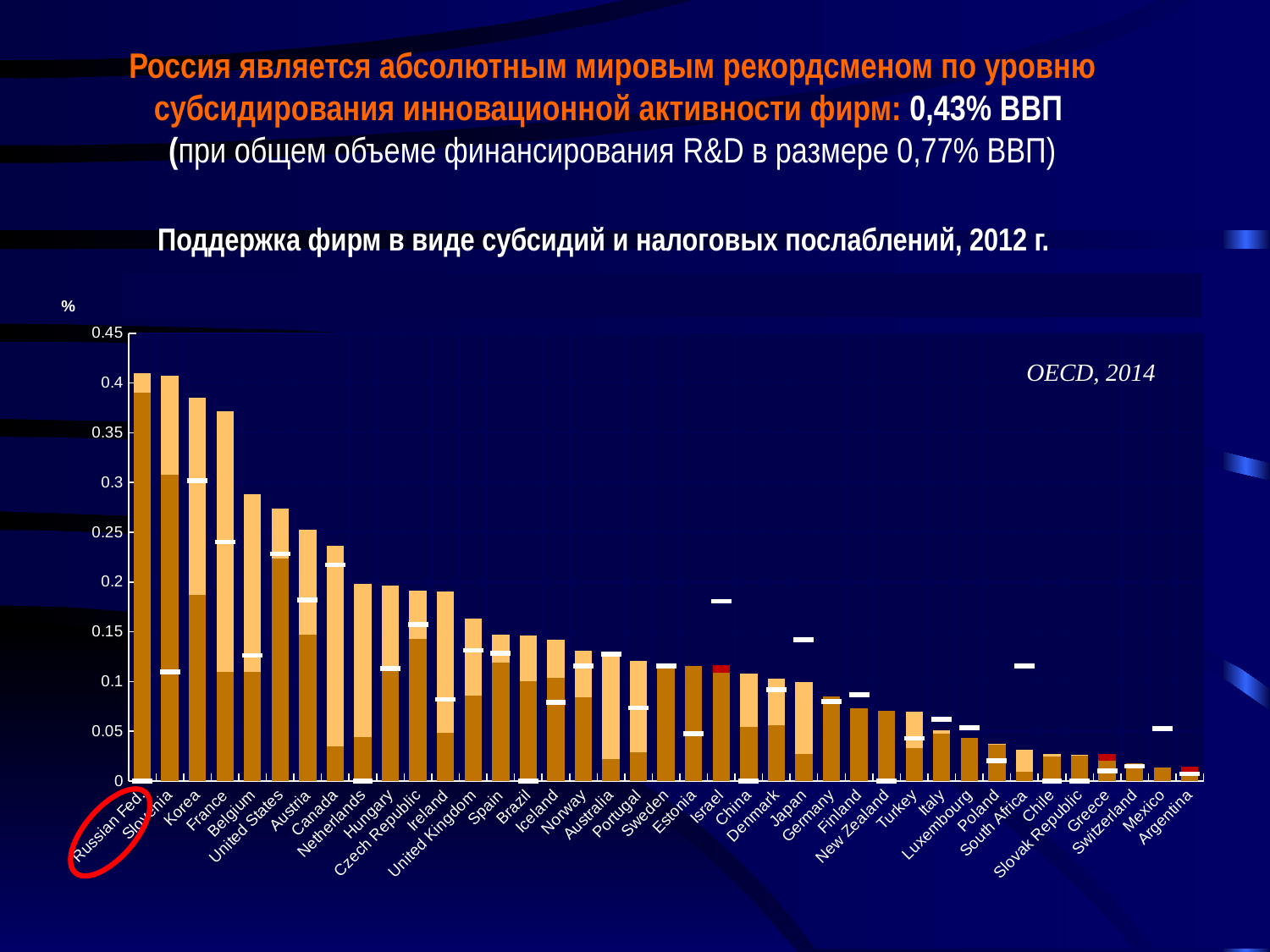
How many countries are shown on the x axis of the chart? 39 Is the value for Canada greater or less than 0.25? less Which has the larger value, Korea or Belgium? Korea Which country's label is circled in red on the chart? Russian Fed. Is the value for Poland greater or less than 0.05? less Is the value for Korea greater or less than 0.35? greater Which has the larger value, Sweden or Poland? Sweden What kind of chart is shown on the slide? bar chart What source is cited on the chart? OECD, 2014 Do the bar heights generally rise or fall moving from left to right along the x axis? fall